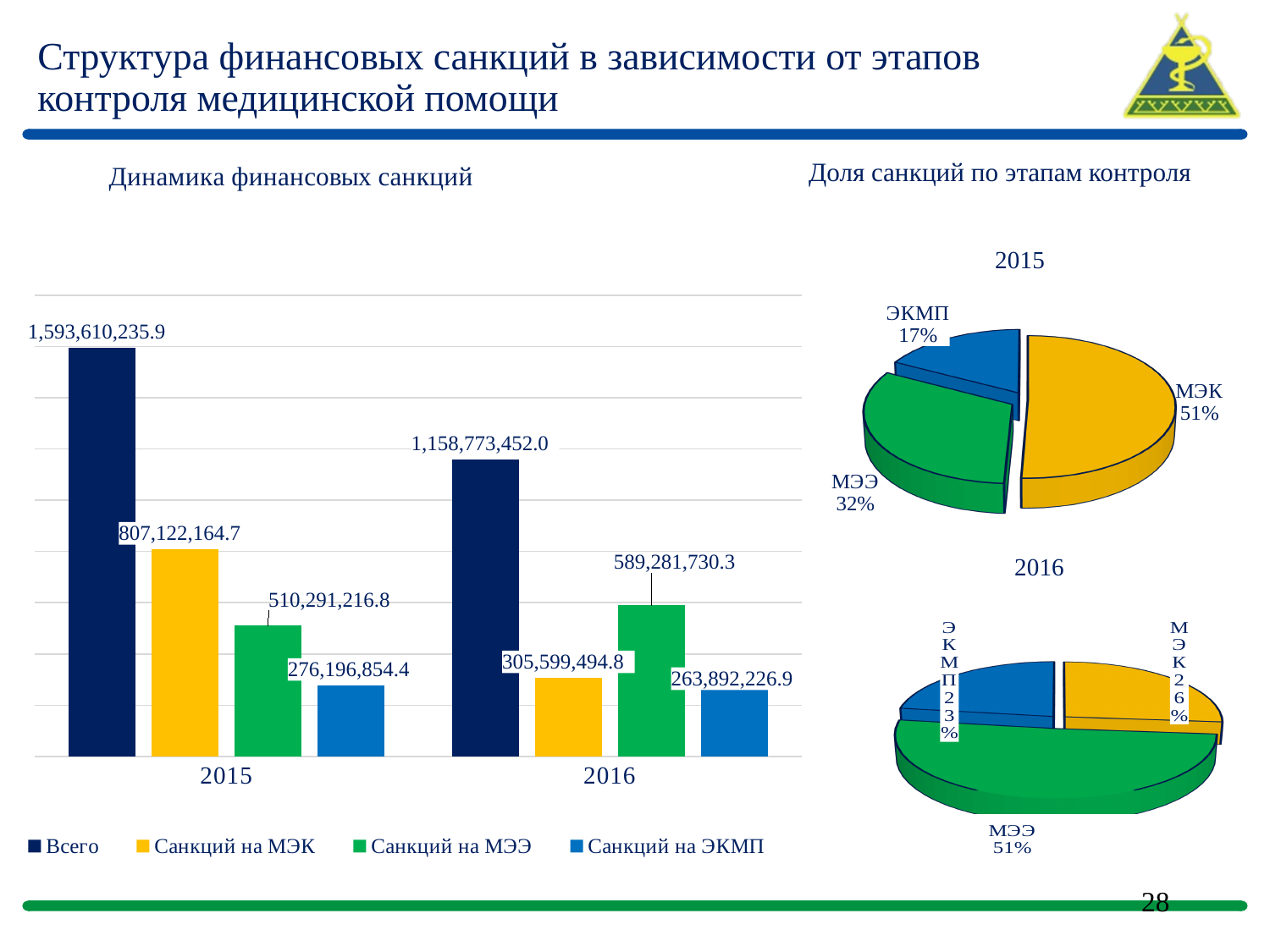
In the 2016 pie chart under "Доля санкций по этапам контроля", what share does ЭКМП have? 23% What type of chart is "Динамика финансовых санкций"? bar chart In the bar chart "Динамика финансовых санкций", how many series does the legend list? 4 In the bar chart "Динамика финансовых санкций", what is the value of "Санкций на ЭКМП" for 2015? 276,196,854.4 In the bar chart "Динамика финансовых санкций", which series has the highest value in 2016, excluding "Всего"? Санкций на МЭЭ In the 2015 pie chart under "Доля санкций по этапам контроля", what share does МЭК have? 51% In the bar chart "Динамика финансовых санкций", what is the value of "Санкций на МЭК" for 2016? 305,599,494.8 In the bar chart "Динамика финансовых санкций", what is the value of "Всего" for 2015? 1,593,610,235.9 In the bar chart "Динамика финансовых санкций", does the value of "Всего" rise or fall from 2015 to 2016? fall In the 2016 pie chart under "Доля санкций по этапам контроля", which slice is the largest? МЭЭ In the bar chart "Динамика финансовых санкций", what is the value of "Санкций на МЭЭ" for 2016? 589,281,730.3 In the bar chart "Динамика финансовых санкций", which is larger: "Санкций на МЭК" in 2015 or "Санкций на МЭК" in 2016? 2015